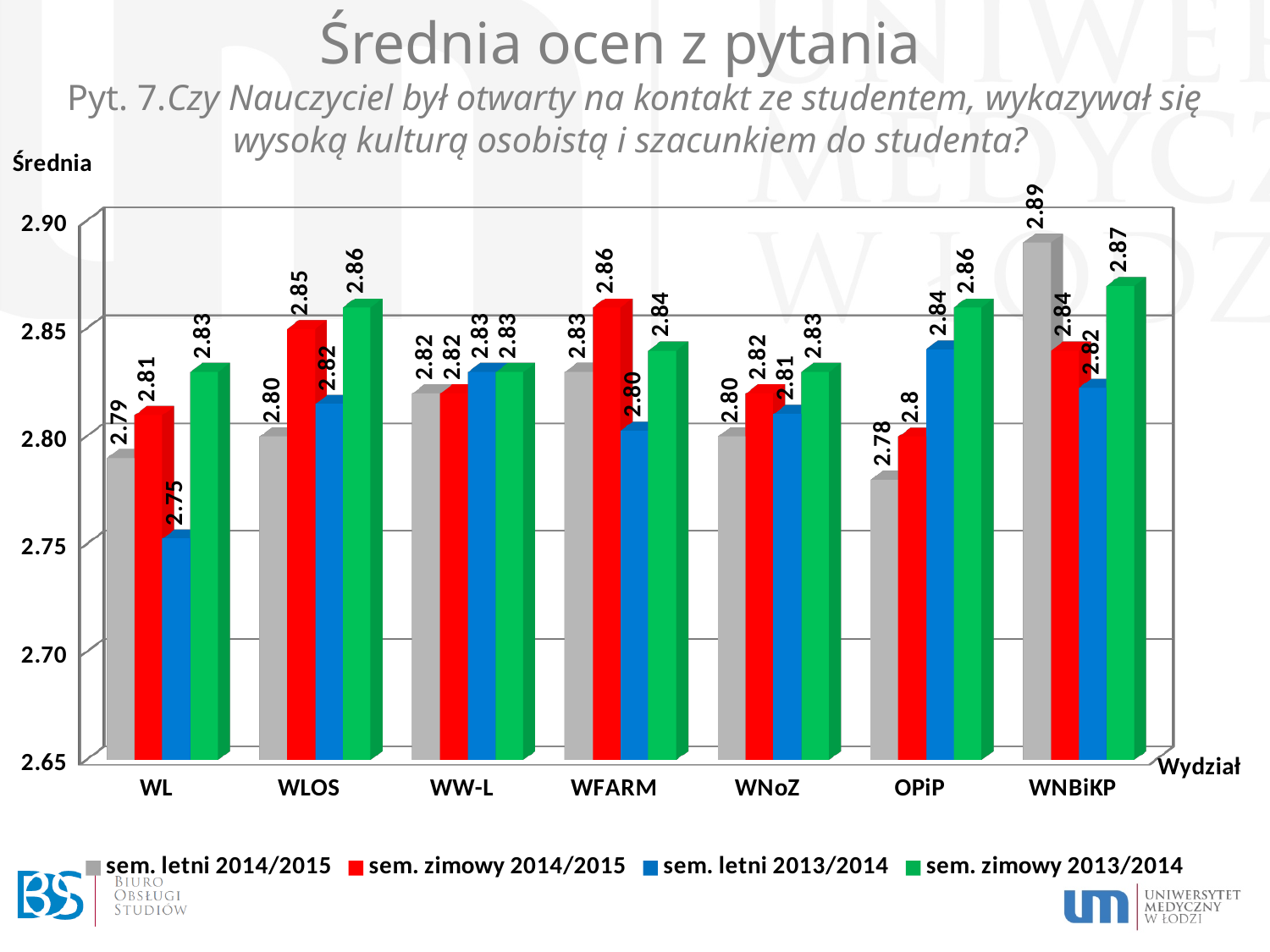
What is the difference between the sem. zimowy 2013/2014 value and the sem. letni 2013/2014 value for WL? 0.08 What is the value for WFARM in the sem. zimowy 2014/2015 series? 2.86 Which category has the highest value in the sem. letni 2014/2015 series? WNBiKP Which is larger for OPiP: the sem. letni 2014/2015 value or the sem. zimowy 2013/2014 value? sem. zimowy 2013/2014 What is the value for WNBiKP in the sem. letni 2014/2015 series? 2.89 Which category has the lowest value in the sem. letni 2013/2014 series? WL What kind of chart is shown on the slide? bar chart What is the value for OPiP in the sem. zimowy 2014/2015 series? 2.8 How many series does the legend list? 4 Which colour represents the sem. zimowy 2013/2014 series? green What is the value for WL in the sem. letni 2013/2014 series? 2.75 How many categories (wydziały) are shown on the x axis? 7